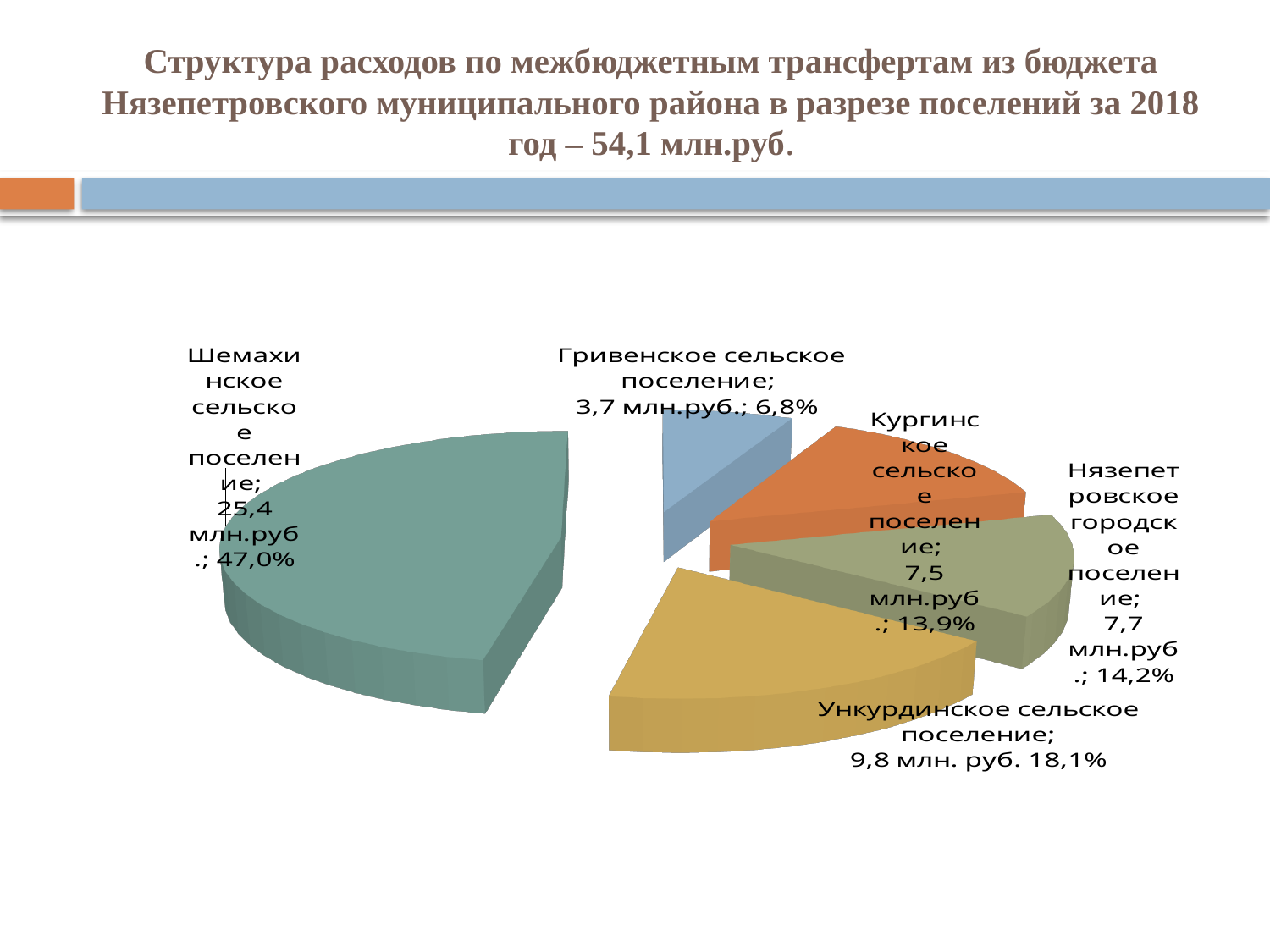
What amount in млн.руб. is shown for Шемахинское сельское поселение? 25,4 млн.руб. What amount is shown for Ункурдинское сельское поселение? 9,8 млн. руб. How many settlements (slices) are shown in the pie chart? 5 What amount is shown for Кургинское сельское поселение? 7,5 млн.руб. Which settlement has the largest share of the pie? Шемахинское сельское поселение What is the difference in млн.руб. between Шемахинское сельское поселение and Гривенское сельское поселение? 21,7 млн.руб. Which settlement has the smallest share of the pie? Гривенское сельское поселение What type of chart is shown on the slide? Pie chart Which is larger: the amount for Ункурдинское сельское поселение or for Кургинское сельское поселение? Ункурдинское сельское поселение What share of the pie does Гривенское сельское поселение have? 6,8% What total amount of intergovernmental transfers for 2018 is stated in the slide title? 54,1 млн.руб. What percentage is shown for Нязепетровское городское поселение? 14,2%